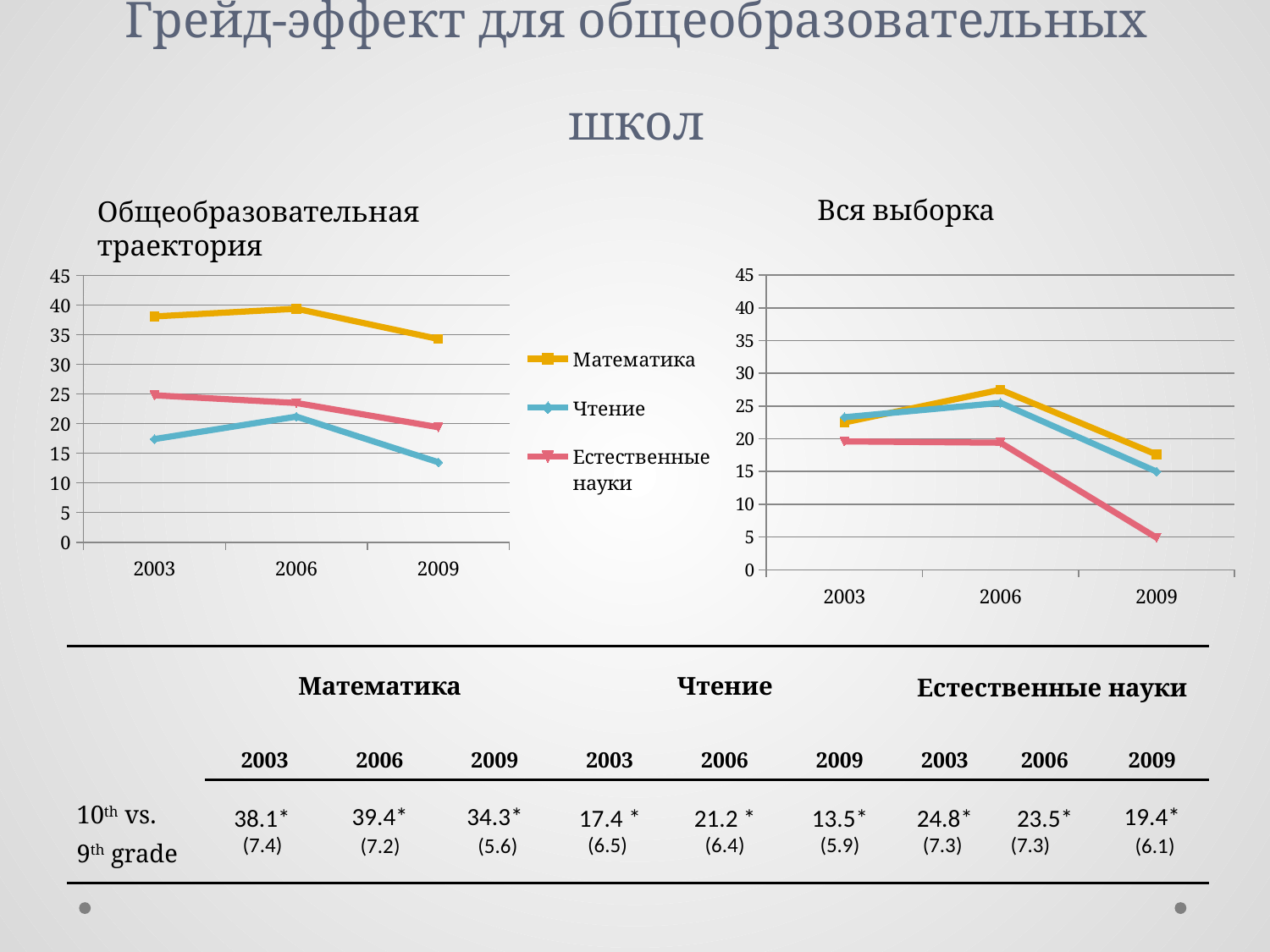
In the left chart "Общеобразовательная траектория", is the value for Математика in 2003 greater or less than 35? greater In the right chart "Вся выборка", how many years are shown on the x axis? 3 In the left chart "Общеобразовательная траектория", which is larger in 2003: Естественные науки or Чтение? Естественные науки In the left chart "Общеобразовательная траектория", which series has the highest value in 2006? Математика In the left chart "Общеобразовательная траектория", is the value for Чтение in 2009 greater or less than 15? less What kind of chart is the left chart titled "Общеобразовательная траектория"? line chart In the left chart "Общеобразовательная траектория", how many series does the legend list? 3 In the right chart "Вся выборка", does the Естественные науки line rise or fall from 2006 to 2009? fall In the right chart "Вся выборка", which series has the highest value in 2006? Математика In the right chart "Вся выборка", is the value for Естественные науки in 2009 greater or less than 10? less What is the title of the right chart on the slide? Вся выборка In the left chart "Общеобразовательная траектория", which series has the lowest value in 2009? Чтение